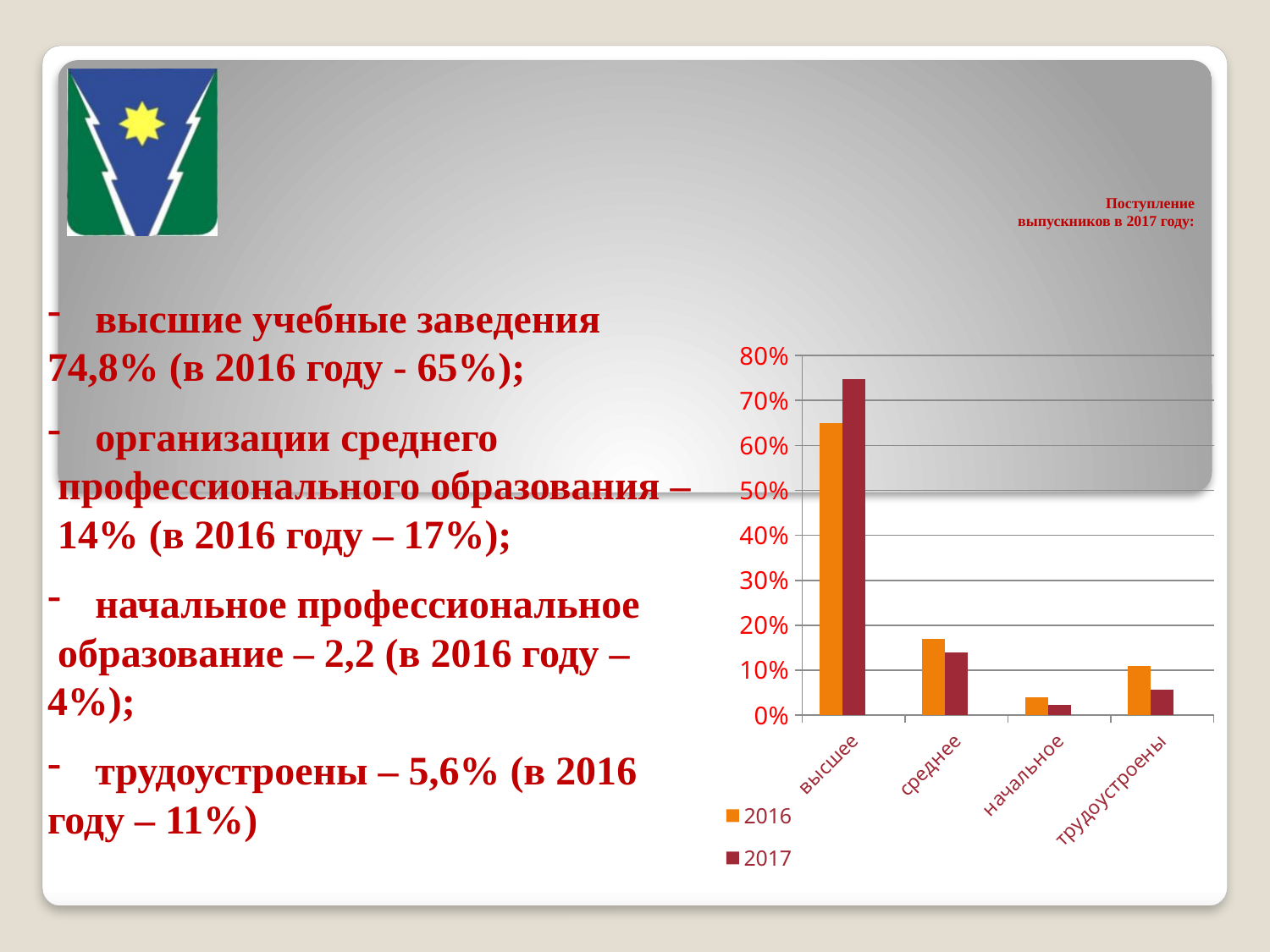
Which category has the lowest bar for the 2017 series? начальное What kind of chart is shown on the slide? bar chart Is the 2016 value for среднее greater or less than 20%? less Is the 2017 value for трудоустроены greater or less than 10%? less Which category has the highest bar for the 2017 series? высшее How many series does the chart legend list? 2 Is the 2016 value for высшее greater or less than 60%? greater What are the two series named in the chart legend? 2016 and 2017 How many categories are shown on the x axis of the chart? 4 For the category трудоустроены, which series has the larger value, 2016 or 2017? 2016 For the category высшее, which series has the larger value, 2016 or 2017? 2017